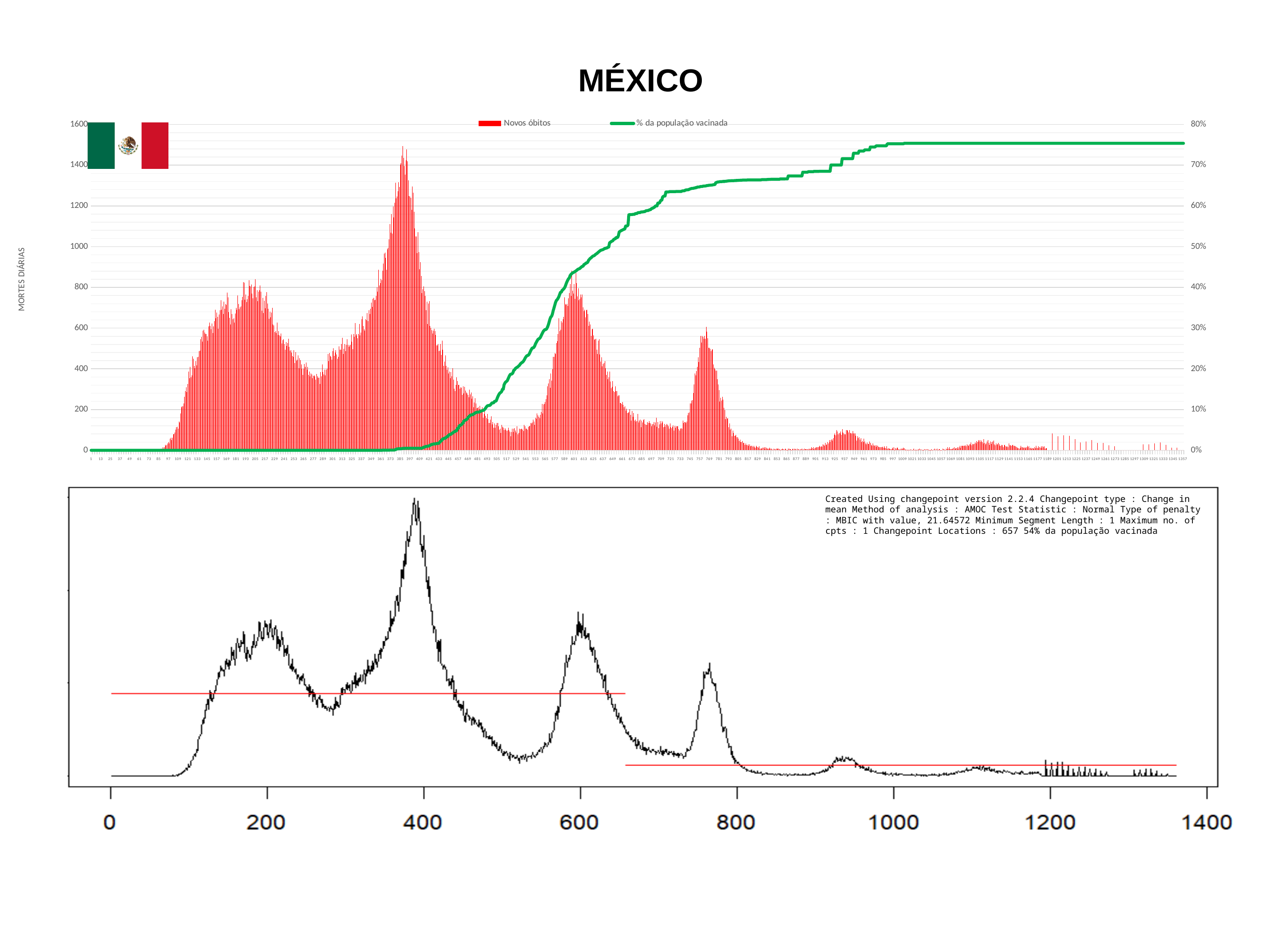
In the bottom chart, what changepoint location is reported in the annotation text? 657 In the top chart, what is the maximum value shown on the right-hand axis? 80% What kind of chart is the bottom chart on the slide? line chart In the bottom chart, what is the MBIC penalty value reported in the annotation text? 21.64572 What is the title of the slide's top chart? MÉXICO In the top chart, is the value of '% da população vacinada' at day 800 greater or less than 60%? greater In the top chart, is the highest value of 'Novos óbitos' greater or less than 1200? greater In the top chart, how many series does the legend list? 2 In the top chart, what are the two legend entries? Novos óbitos; % da população vacinada In the top chart, is the final value of '% da população vacinada' greater or less than 70%? greater In the top chart, does the '% da população vacinada' line rise or fall along the x axis? rise In the top chart, what kind of chart is used for the 'Novos óbitos' series? bar chart